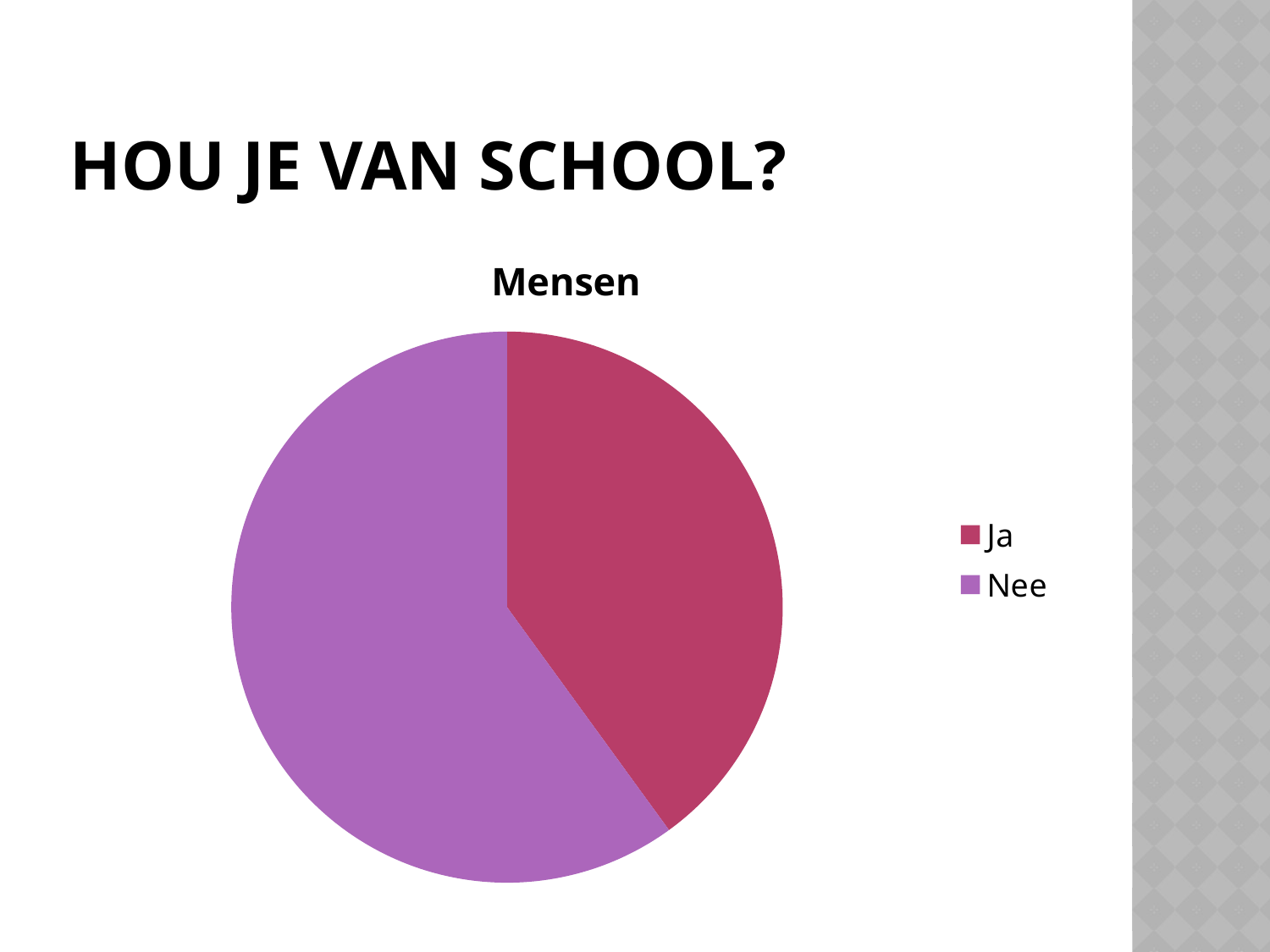
Is the share of the Nee slice greater or less than 50%? greater Is the share of the Ja slice greater or less than 50%? less How many entries does the legend list? 2 What colour is the Ja slice? red What is the title of the chart? Mensen Which slice is the smallest in the pie chart? Ja How many slices does the pie chart have? 2 What kind of chart is shown on the slide? pie chart Which slice is the largest in the pie chart? Nee Which slice is larger, Ja or Nee? Nee